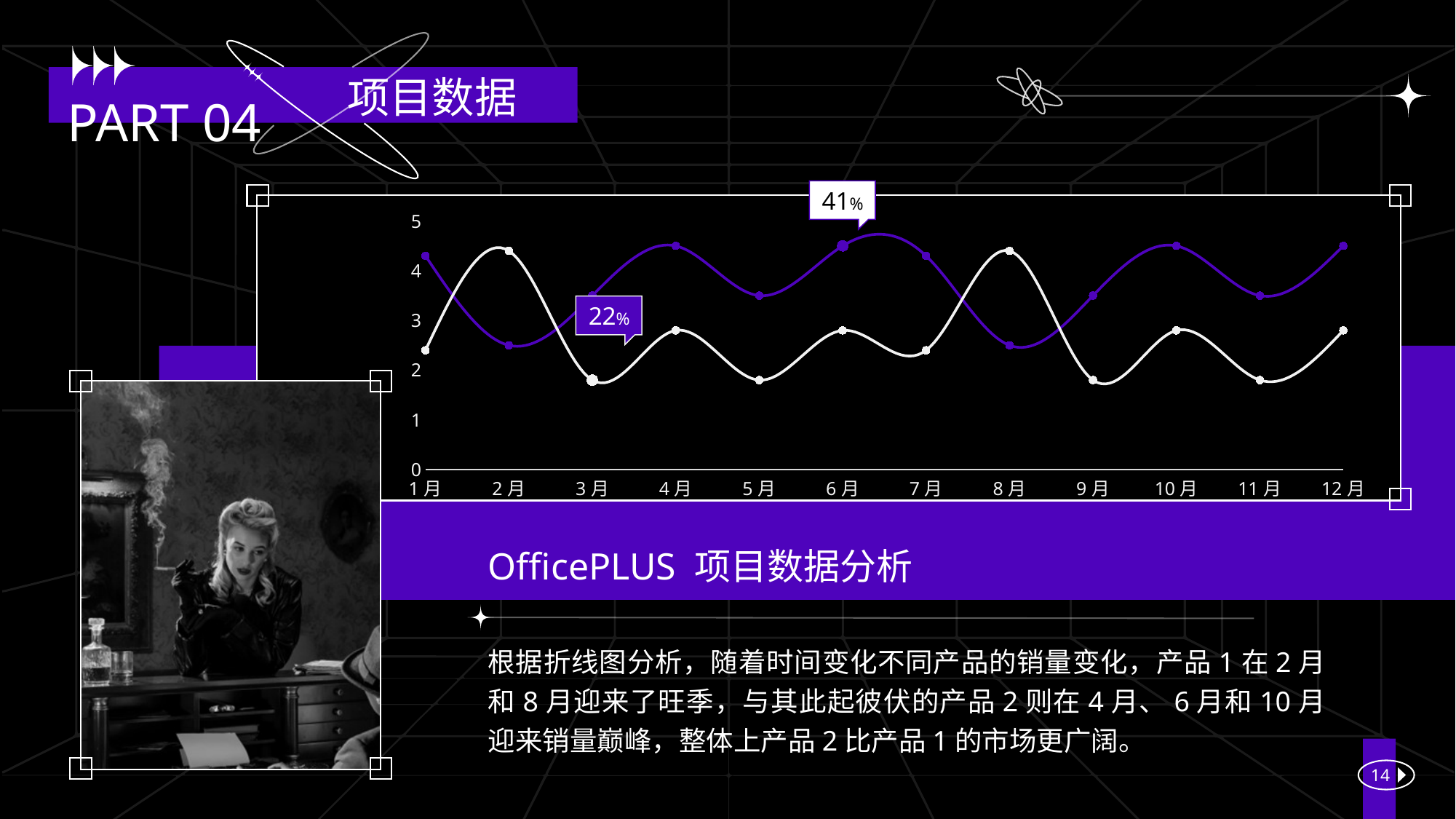
What kind of chart is shown on the slide? line chart What text is shown in the callout label attached to the white line at 3月? 22% At 2月, which line has the higher value, the white line or the purple line? the white line Is the value of the purple line at 6月 greater or less than 4? greater Is the value of the white line at 3月 greater or less than 2? less At 4月, which line has the higher value, the white line or the purple line? the purple line What text is shown in the callout label attached to the purple line at 6月? 41% Does the white line rise or fall from 1月 to 2月? rise Is the value of the purple line at 2月 greater or less than 3? less How many lines are plotted on the chart? 2 How many months are shown along the x axis of the chart? 12